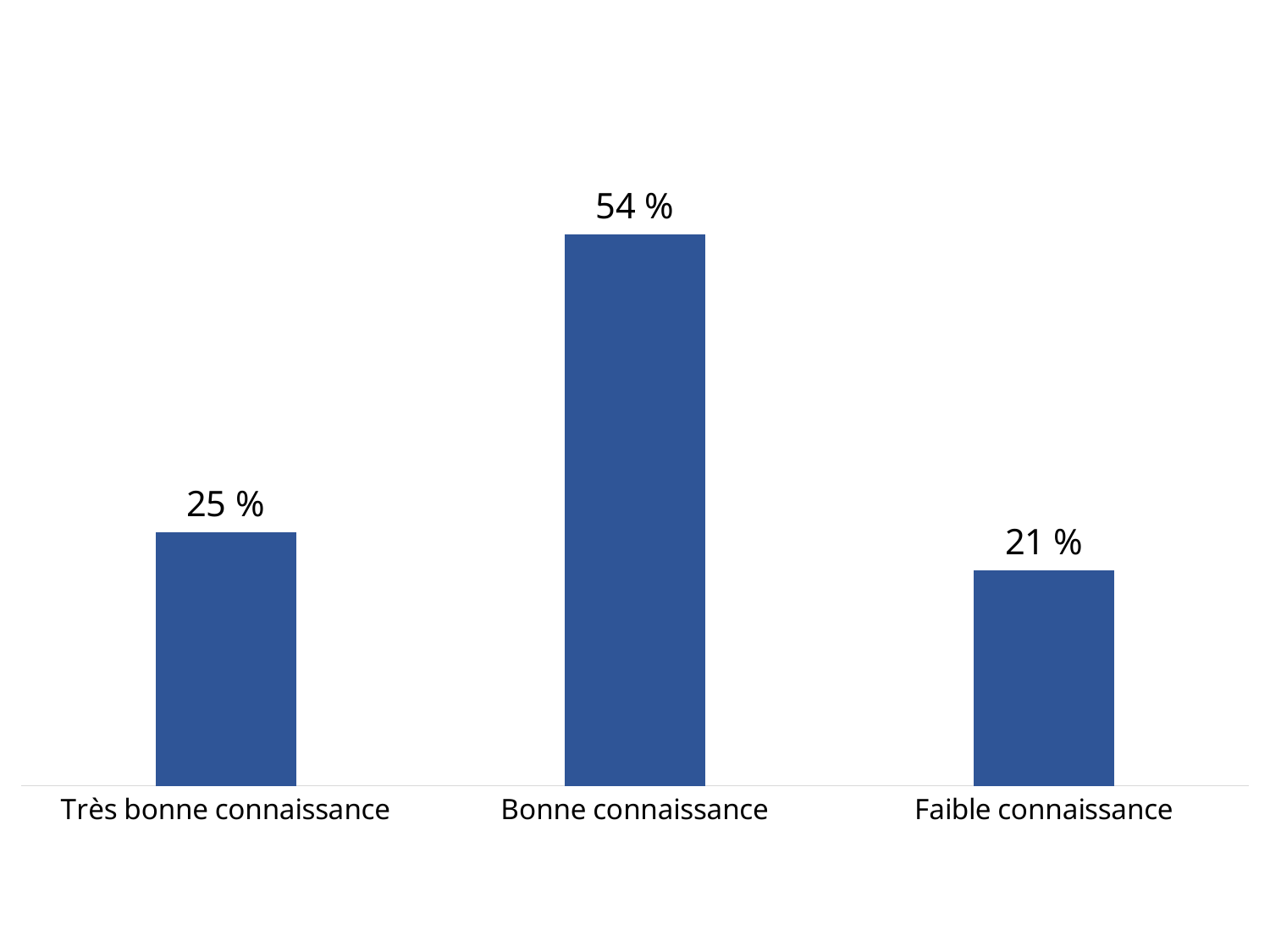
What is the value for Très bonne connaissance? 25 % What is the difference between the values for Très bonne connaissance and Faible connaissance? 4 % What kind of chart is shown on the slide? Bar chart What colour are the bars in the chart? Blue Which category has the highest value? Bonne connaissance Which category has the lowest value? Faible connaissance What is the value for Faible connaissance? 21 % What is the difference between the values for Bonne connaissance and Très bonne connaissance? 29 % What is the value for Bonne connaissance? 54 % How many categories are shown in the chart? 3 Which is larger, the value for Très bonne connaissance or the value for Faible connaissance? Très bonne connaissance What is the label of the middle category on the x axis? Bonne connaissance